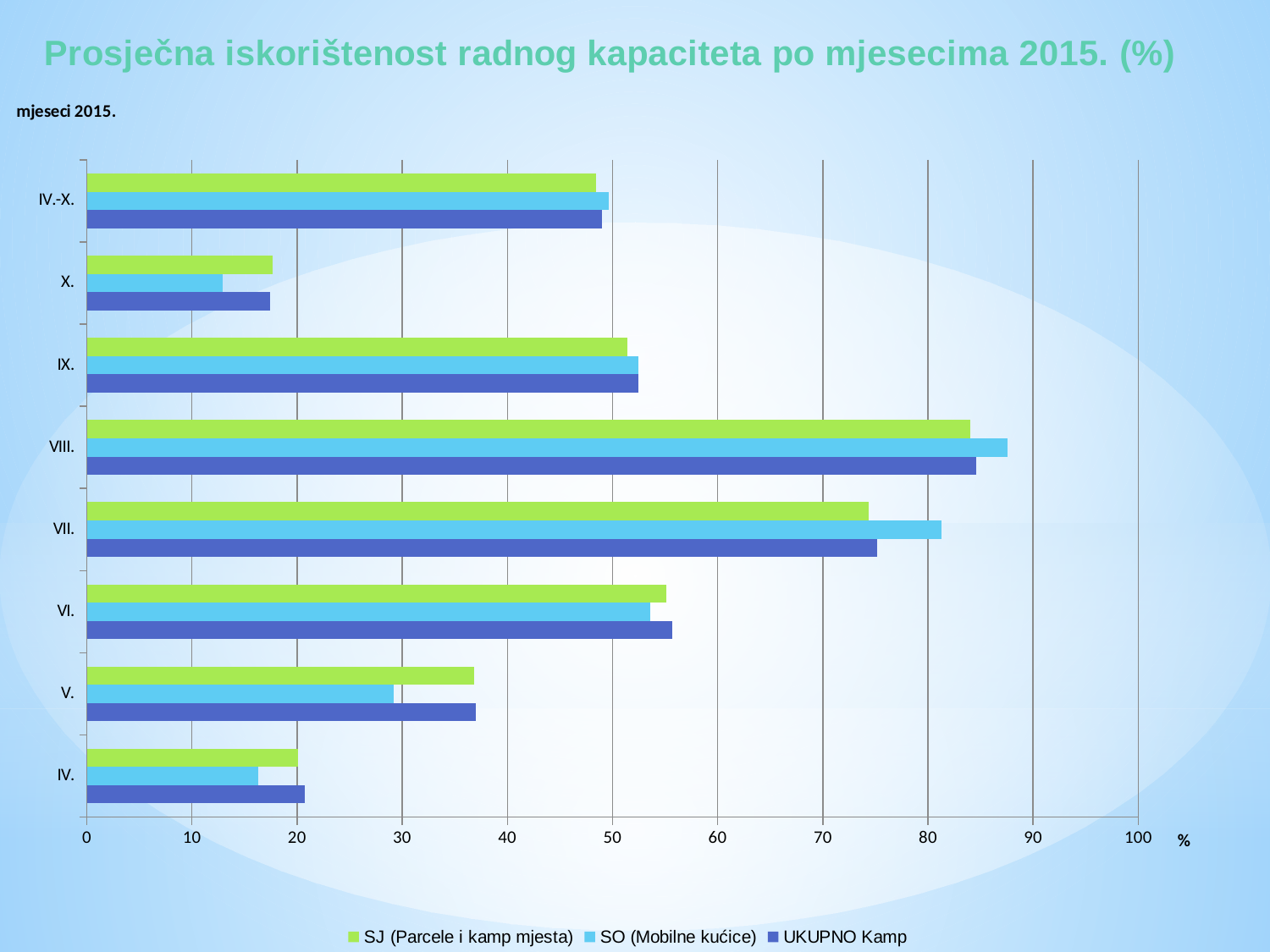
Is the value for SO (Mobilne kućice) in VII. greater or less than 70? greater How many categories are shown on the vertical axis? 8 What kind of chart is shown on the slide? bar chart In V., which is larger: SJ (Parcele i kamp mjesta) or SO (Mobilne kućice)? SJ (Parcele i kamp mjesta) Which category has the lowest value for SO (Mobilne kućice)? X. Is the value for SO (Mobilne kućice) in X. greater or less than 20? less How many series does the legend list? 3 What is the title of the chart? Prosječna iskorištenost radnog kapaciteta po mjesecima 2015. (%) In VII., which is larger: SO (Mobilne kućice) or SJ (Parcele i kamp mjesta)? SO (Mobilne kućice) Which category has the highest value for SJ (Parcele i kamp mjesta)? VIII. Is the value for UKUPNO Kamp in V. greater or less than 40? less Which category has the highest value for SO (Mobilne kućice)? VIII.